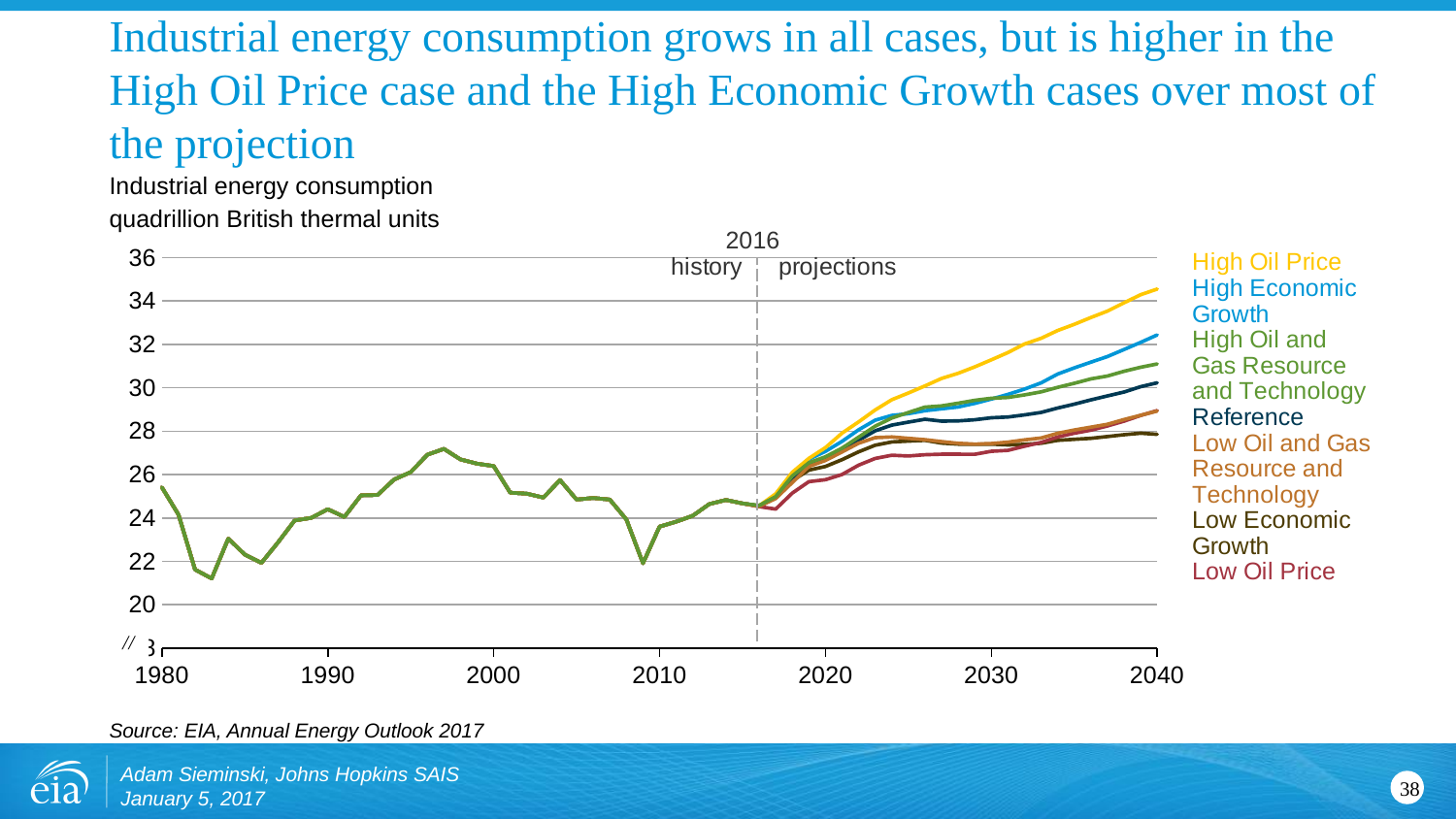
Do the projected values rise or fall between 2016 and 2040? rise What kind of chart is shown on the slide? line chart Is the value for the Reference case in 2040 greater or less than 28? greater Is the historical value in 1980 greater or less than 24? greater Which case has the highest industrial energy consumption in 2040? High Oil Price Which is larger in 2040, the High Economic Growth case or the Low Economic Growth case? High Economic Growth Is the historical value around 2009 greater or less than 24? less What unit is industrial energy consumption measured in on the chart? quadrillion British thermal units How many series does the legend list? 7 What year separates history from projections on the chart? 2016